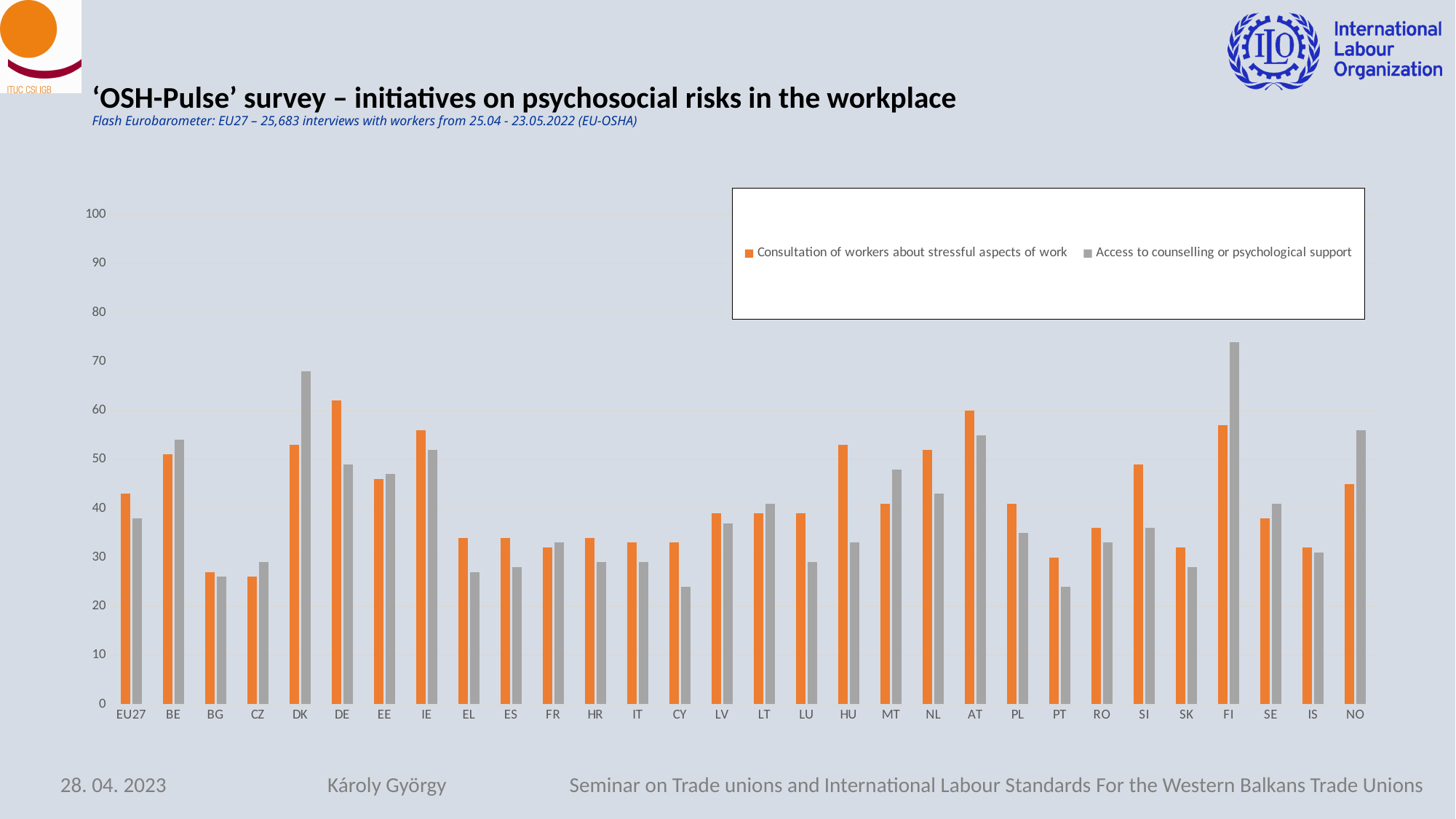
How many series does the legend list? 2 Which category has the highest value for 'Access to counselling or psychological support'? FI What kind of chart is shown on the slide? bar chart How many categories are shown along the x axis? 30 Is the value for 'Access to counselling or psychological support' in FI greater or less than 70? greater For DK, which series has the larger value: 'Consultation of workers about stressful aspects of work' or 'Access to counselling or psychological support'? Access to counselling or psychological support Is the value for 'Access to counselling or psychological support' in PT greater or less than 30? less What colour represents 'Consultation of workers about stressful aspects of work' in the legend? orange Is the value for 'Access to counselling or psychological support' in DK greater or less than 60? greater For HU, which series has the larger value: 'Consultation of workers about stressful aspects of work' or 'Access to counselling or psychological support'? Consultation of workers about stressful aspects of work